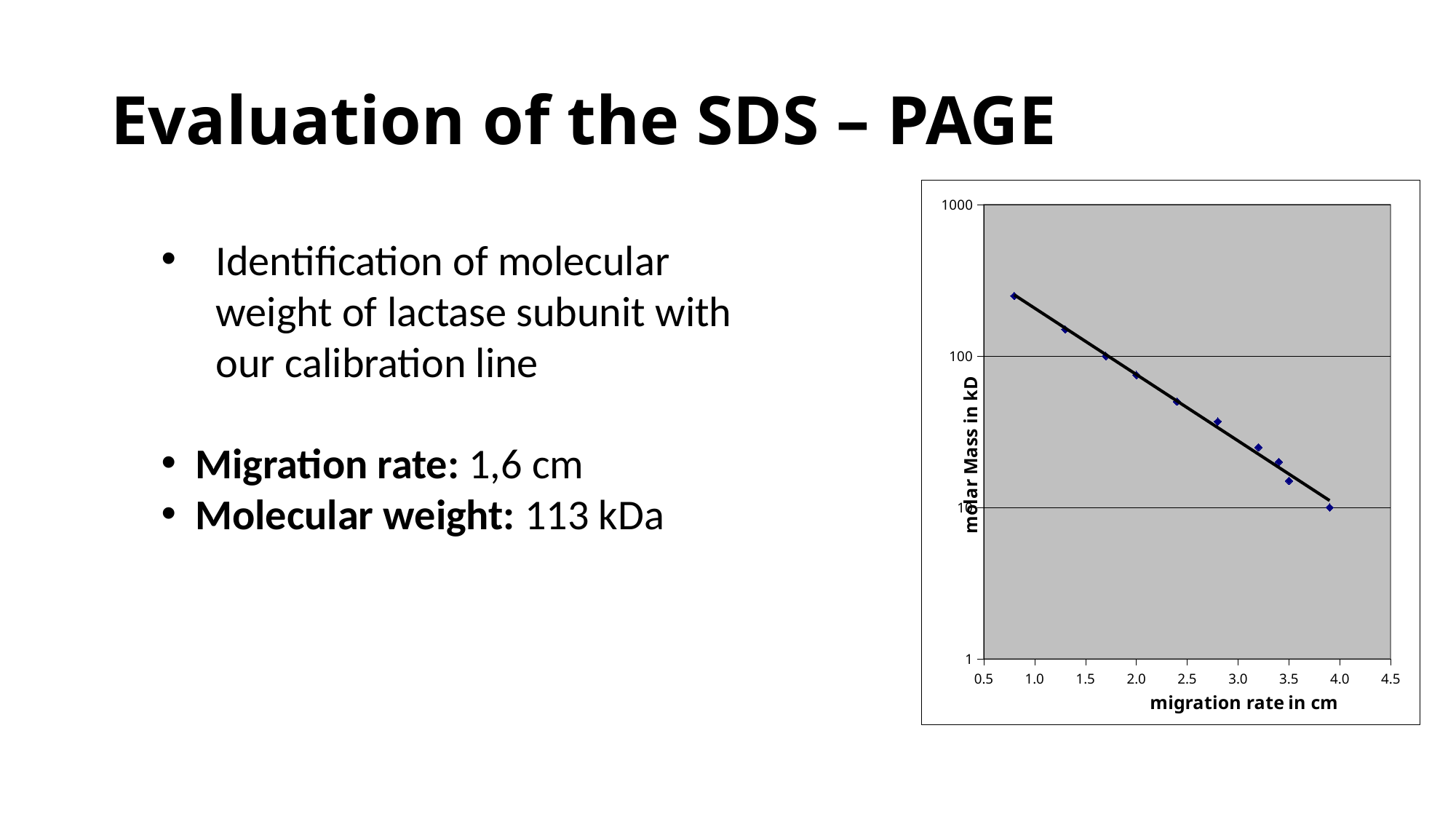
Which data point has the lowest molar mass: the leftmost or the rightmost point? the rightmost point Which data point has the higher molar mass: the one at a migration rate of about 1.3 cm or the one at about 3.2 cm? the one at about 1.3 cm What is the title of the x axis of the chart? migration rate in cm What is the title of the y axis of the chart? molar Mass in kD Is the molar mass of the leftmost data point (migration rate near 0.8 cm) greater or less than 100? greater Is the molar mass of the data point at a migration rate of about 3.5 cm greater or less than 10? greater Does the molar mass rise or fall as the migration rate increases along the x axis? fall Is the molar mass of the data point at a migration rate of about 2.4 cm greater or less than 100? less What kind of chart is shown on the slide? scatter chart How many data points are plotted on the chart? 10 Which data point has the highest molar mass: the leftmost or the rightmost point? the leftmost point